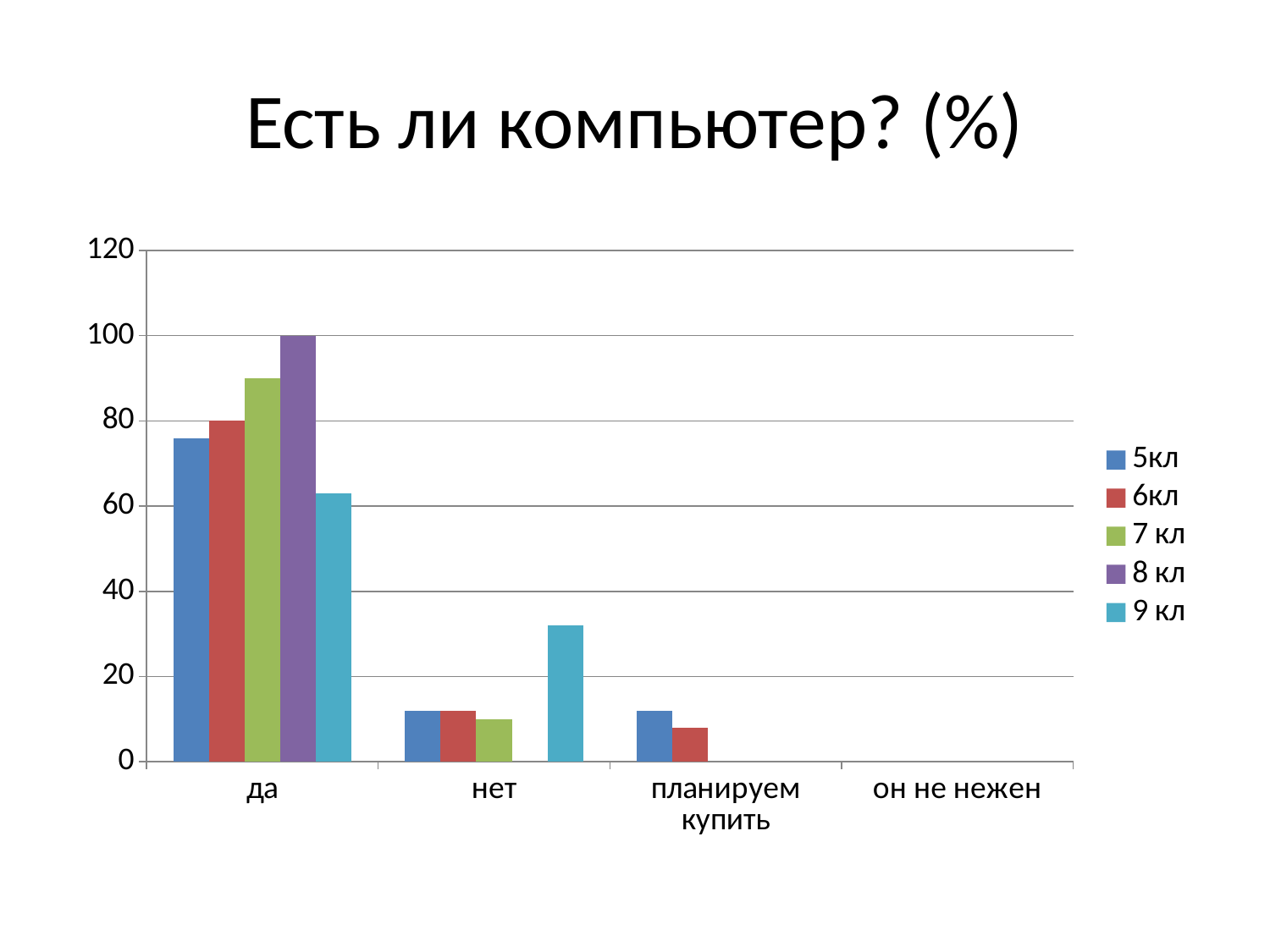
Which series has the highest value in the category "нет"? 9 кл Is the value for 5кл in the category "да" greater or less than 60? greater What is the title of the chart? Есть ли компьютер? (%) Which series has the lowest value in the category "да"? 9 кл Is the value for 9 кл in the category "нет" greater or less than 20? greater What is the value for 6кл in the category "да"? 80 What type of chart is shown on the slide? bar chart How many categories are shown on the x axis? 4 Which series has the highest value in the category "да"? 8 кл Which is larger in the category "планируем купить": the value for 5кл or for 6кл? 5кл How many series does the legend list? 5 What is the value for 8 кл in the category "да"? 100